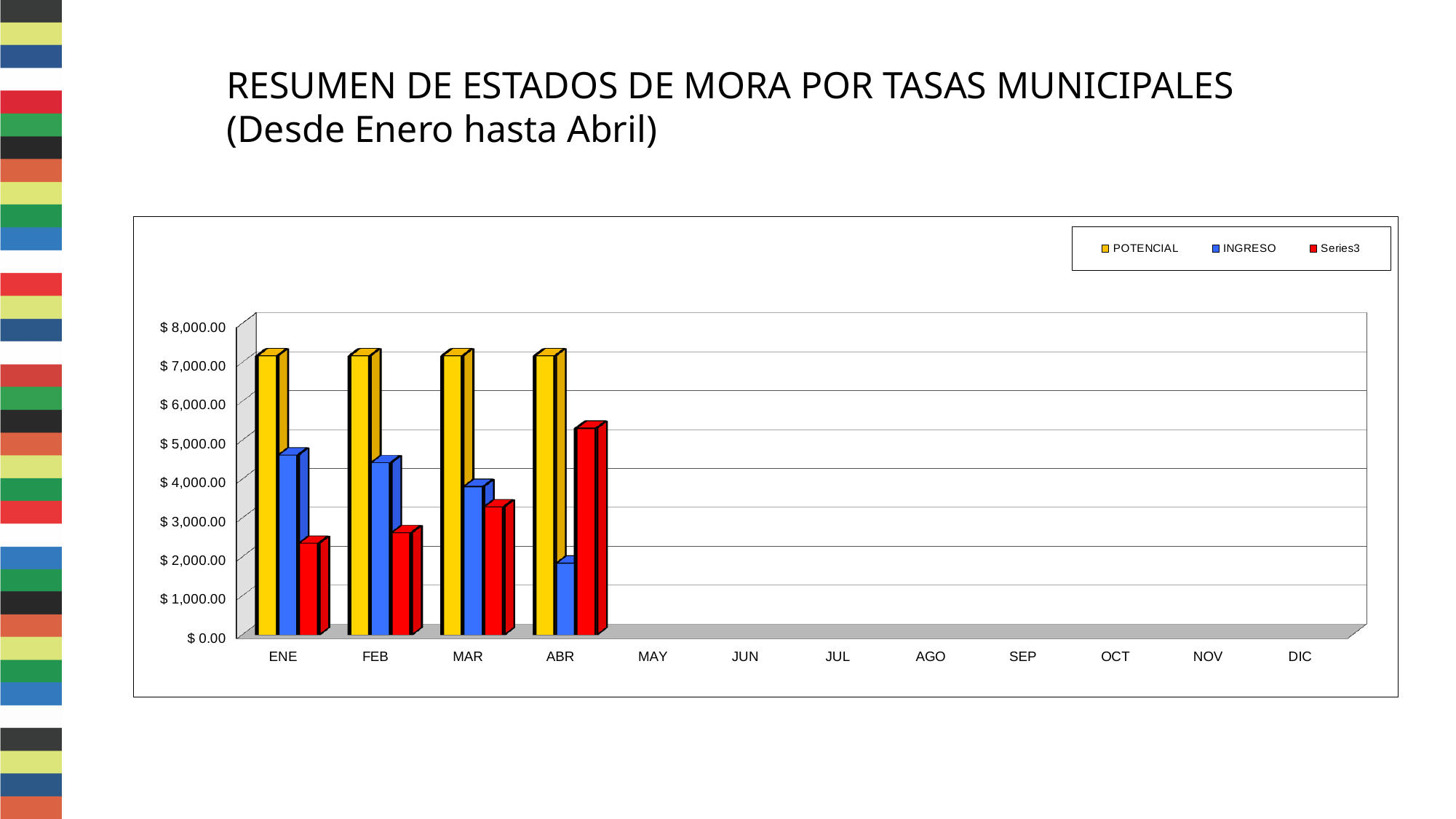
How many series does the legend list? 3 Which series is shown in yellow in the legend? POTENCIAL Is the INGRESO value for ENE greater or less than 4,000? greater In which month is the Series3 value highest? ABR For ENE, which is larger: INGRESO or Series3? INGRESO Is the INGRESO value for ABR greater or less than 2,000? less Is the Series3 value for ABR greater or less than 5,000? greater What kind of chart is shown on the slide? bar chart Does the INGRESO series rise or fall from ENE to ABR? fall In which month is the INGRESO value lowest? ABR How many month categories are shown along the x axis? 12